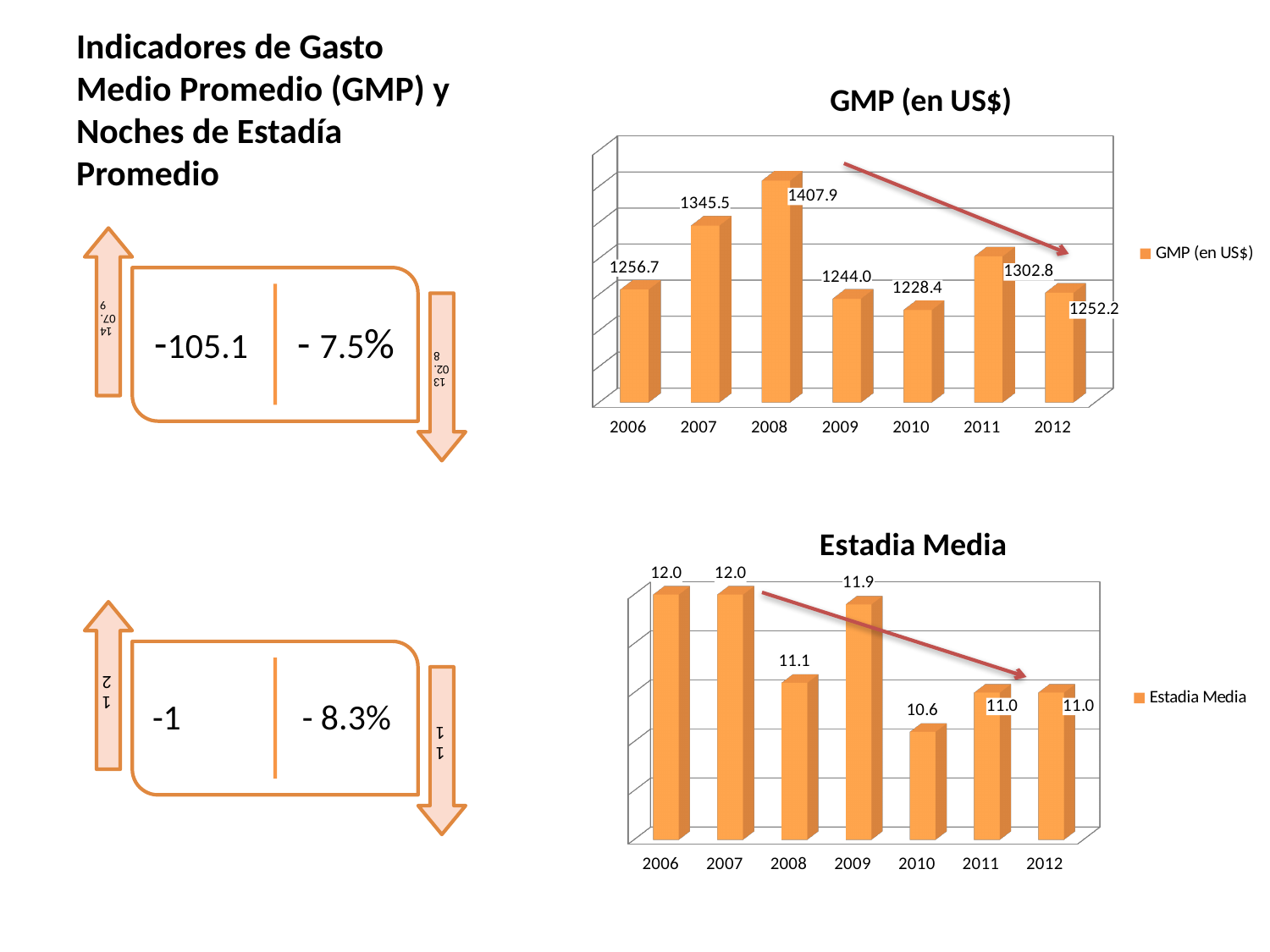
In the 'Estadia Media' chart, do the values generally rise or fall from 2006 to 2012? fall In the 'GMP (en US$)' chart, which year has the lowest value? 2010 In the 'GMP (en US$)' chart, which year has the highest value? 2008 What kind of chart is the 'Estadia Media' chart? bar chart In the 'Estadia Media' chart, what is the difference between the 2006 value and the 2008 value? 0.9 In the 'Estadia Media' chart, what is the value for 2010? 10.6 In the 'GMP (en US$)' chart, which is larger, the value for 2007 or the value for 2011? 2007 In the 'GMP (en US$)' chart, what is the difference between the 2008 value and the 2012 value? 155.7 In the 'Estadia Media' chart, which year has the lowest value? 2010 How many years are shown on the x axis of the 'GMP (en US$)' chart? 7 In the 'GMP (en US$)' chart, what is the value for 2008? 1407.9 How many series does the legend of the 'Estadia Media' chart list? 1